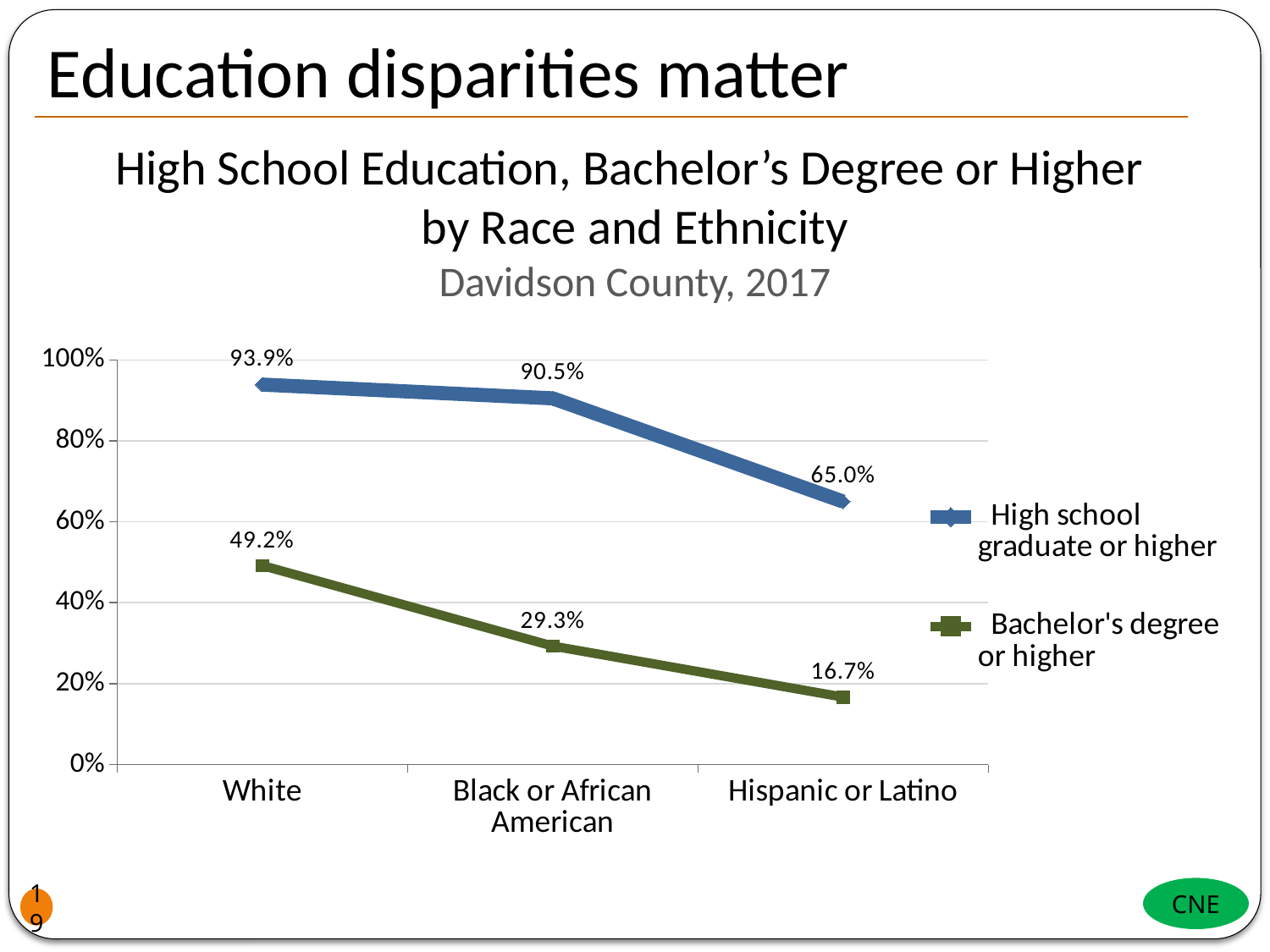
Which is larger: the Bachelor's degree or higher value for Black or African American or for Hispanic or Latino? Black or African American What is the difference between the High school graduate or higher value and the Bachelor's degree or higher value for Hispanic or Latino? 48.3% How many series does the legend list? 2 What is the value for Hispanic or Latino in the Bachelor's degree or higher series? 16.7% What kind of chart is shown on the slide? Line chart What is the value for Black or African American in the High school graduate or higher series? 90.5% Which category has the highest value in the Bachelor's degree or higher series? White What is the value for White in the High school graduate or higher series? 93.9% What is the difference between the Bachelor's degree or higher values for White and Black or African American? 19.9% Which category has the lowest value in the High school graduate or higher series? Hispanic or Latino Do the values in the Bachelor's degree or higher series rise or fall from left to right along the x axis? Fall How many categories are shown on the x axis? 3